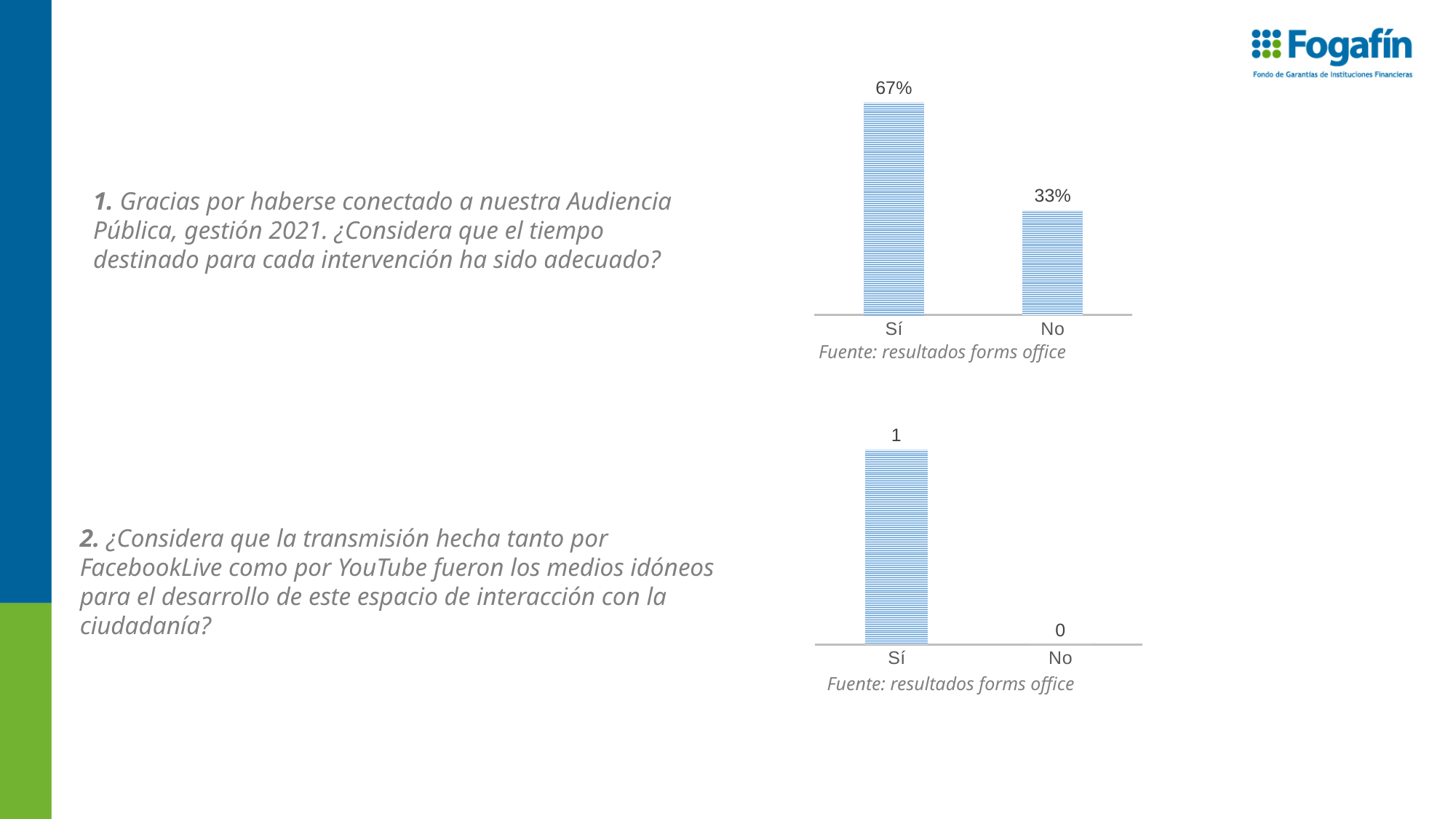
What source is cited below the top chart? Fuente: resultados forms office In the top chart, what is the value for No? 33% In the bottom chart, is the value for Sí larger or smaller than the value for No? Larger In the top chart, what is the difference between the values for Sí and No? 34% In the top chart, what is the value for Sí? 67% In the bottom chart, what is the value for No? 0 In the bottom chart, how many categories are shown? 2 In the top chart, which category has the highest value? Sí In the bottom chart, which category has the lowest value? No What kind of chart is the top chart? Bar chart In the bottom chart, what is the value for Sí? 1 In the top chart, how many categories are shown? 2